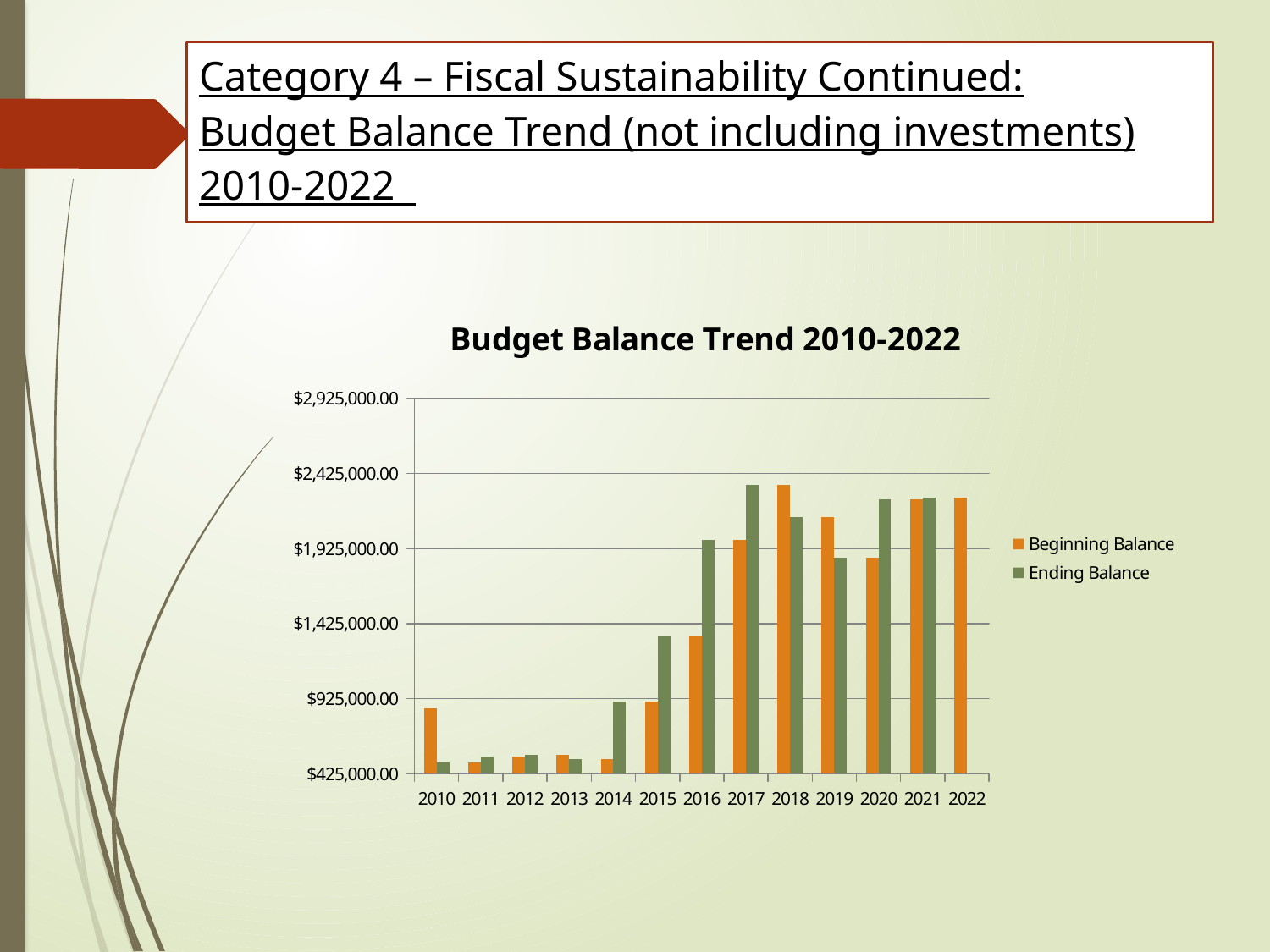
What is the title of the chart? Budget Balance Trend 2010-2022 Is the Beginning Balance for 2016 greater or less than $1,425,000.00? less Which year has the highest Ending Balance? 2017 Does the Beginning Balance rise or fall from 2014 to 2018? Rise In 2017, which is larger, the Beginning Balance or the Ending Balance? Ending Balance Which year has the lowest Ending Balance? 2010 What kind of chart is shown on the slide? Bar chart How many series does the legend list? 2 How many years are shown on the x axis? 13 Is the Beginning Balance for 2018 greater or less than $1,925,000.00? greater Which year has the highest Beginning Balance? 2018 In 2010, which is larger, the Beginning Balance or the Ending Balance? Beginning Balance